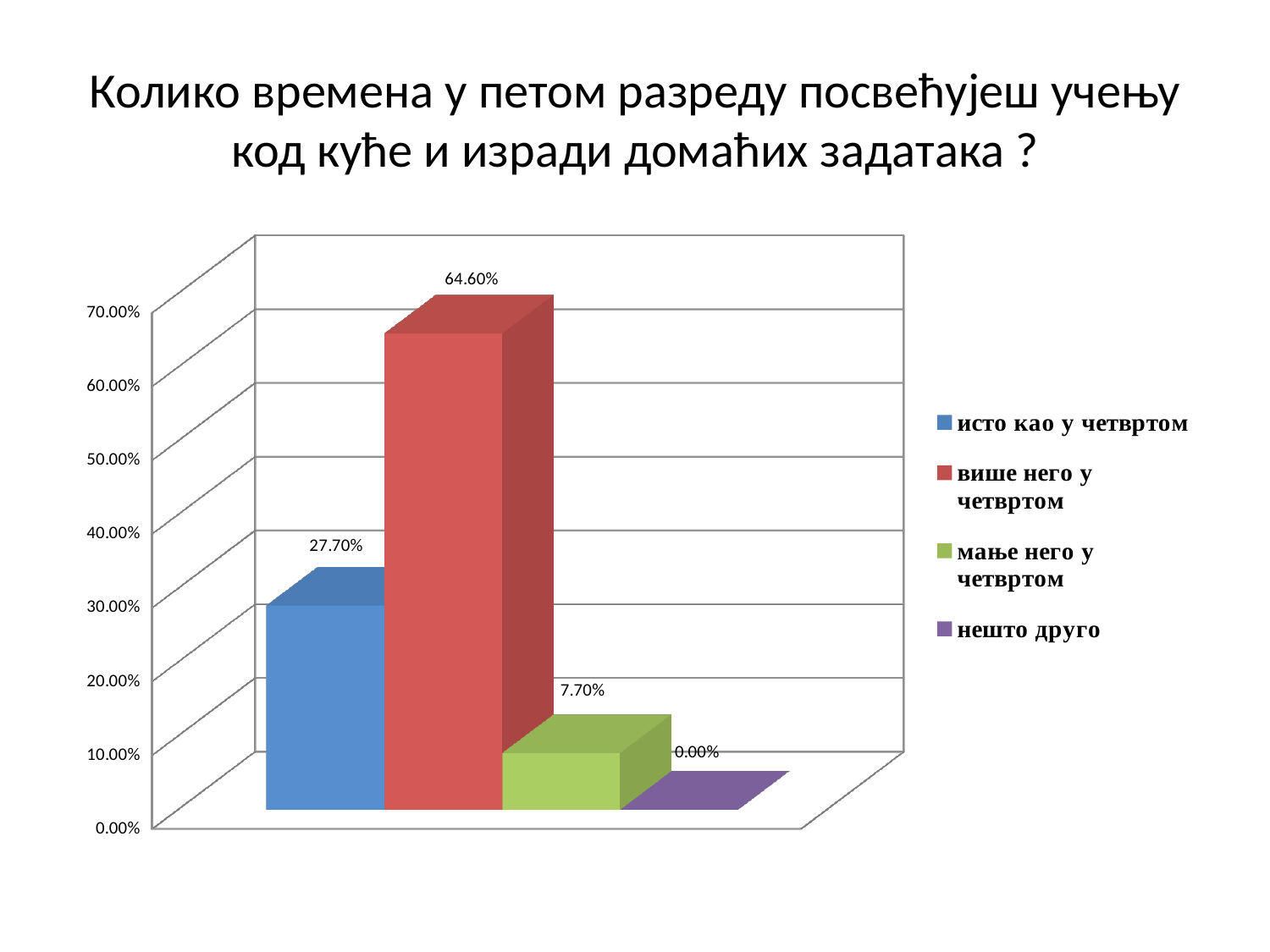
What is the value for "мање него у четвртом"? 7.70% What is the value for "више него у четвртом"? 64.60% Which category has the lowest value? нешто друго What is the difference between the values for "исто као у четвртом" and "мање него у четвртом"? 20.00% How many categories does the legend list? 4 What is the value for "исто као у четвртом"? 27.70% What is the difference between the values for "више него у четвртом" and "исто као у четвртом"? 36.90% What kind of chart is shown on the slide? bar chart What is the value for "нешто друго"? 0.00% What colour is the bar for "више него у четвртом"? red Which category has the highest value? више него у четвртом Which is larger, the value for "исто као у четвртом" or the value for "мање него у четвртом"? исто као у четвртом